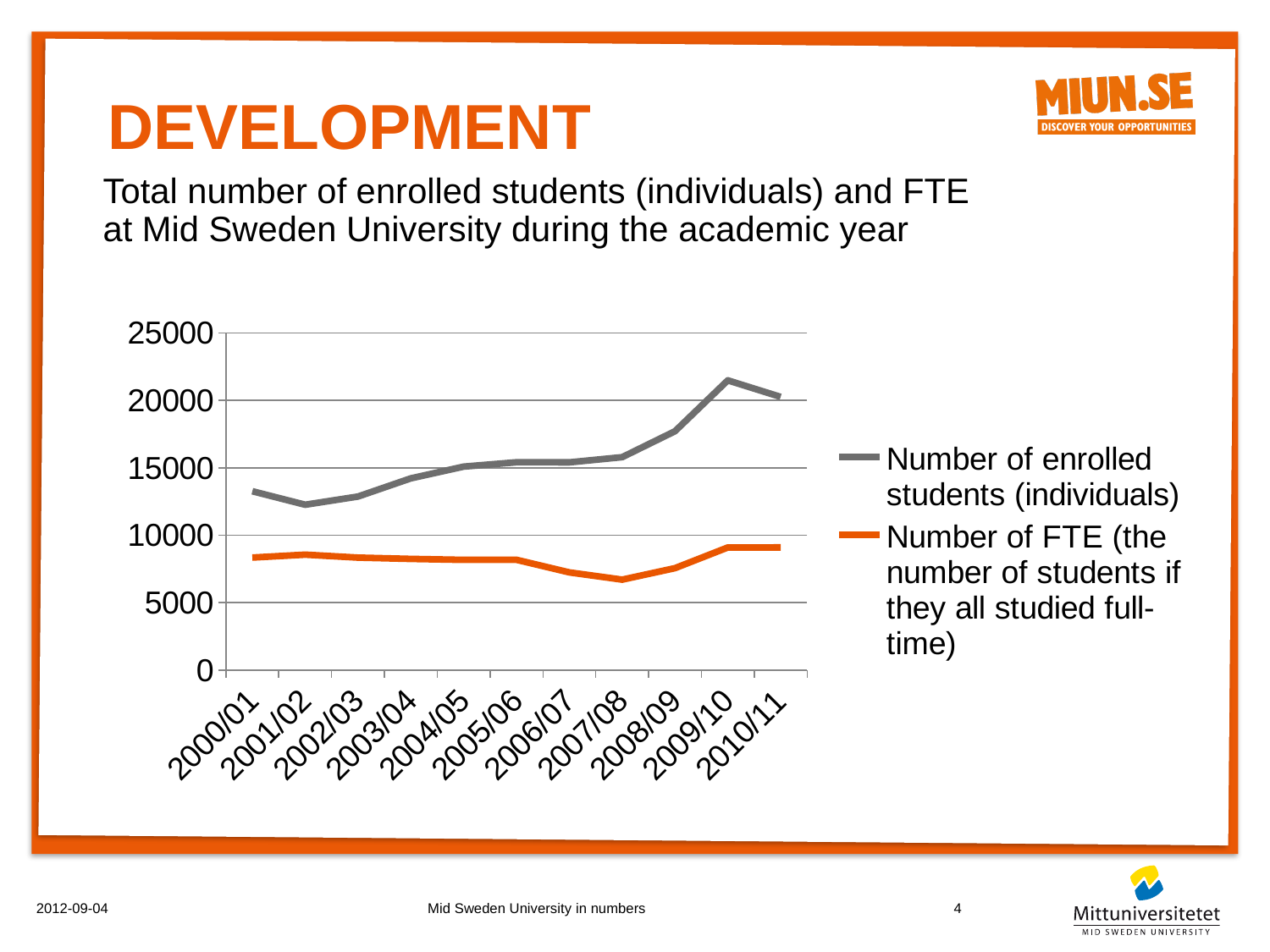
In which academic year is the number of FTE lowest? 2007/08 Which series has higher values throughout the period: Number of enrolled students (individuals) or Number of FTE? Number of enrolled students (individuals) Does the number of enrolled students (individuals) rise or fall between 2001/02 and 2009/10? rise Is the number of enrolled students (individuals) in 2000/01 greater or less than 15000? less In which academic year is the number of enrolled students (individuals) lowest? 2001/02 What kind of chart is shown on the slide? line chart How many series does the legend list? 2 In which academic year is the number of enrolled students (individuals) highest? 2009/10 Is the number of enrolled students (individuals) in 2009/10 greater or less than 20000? greater Is the number of FTE in 2007/08 greater or less than 10000? less What colour is the line for Number of FTE? orange How many academic years are plotted along the x axis? 11